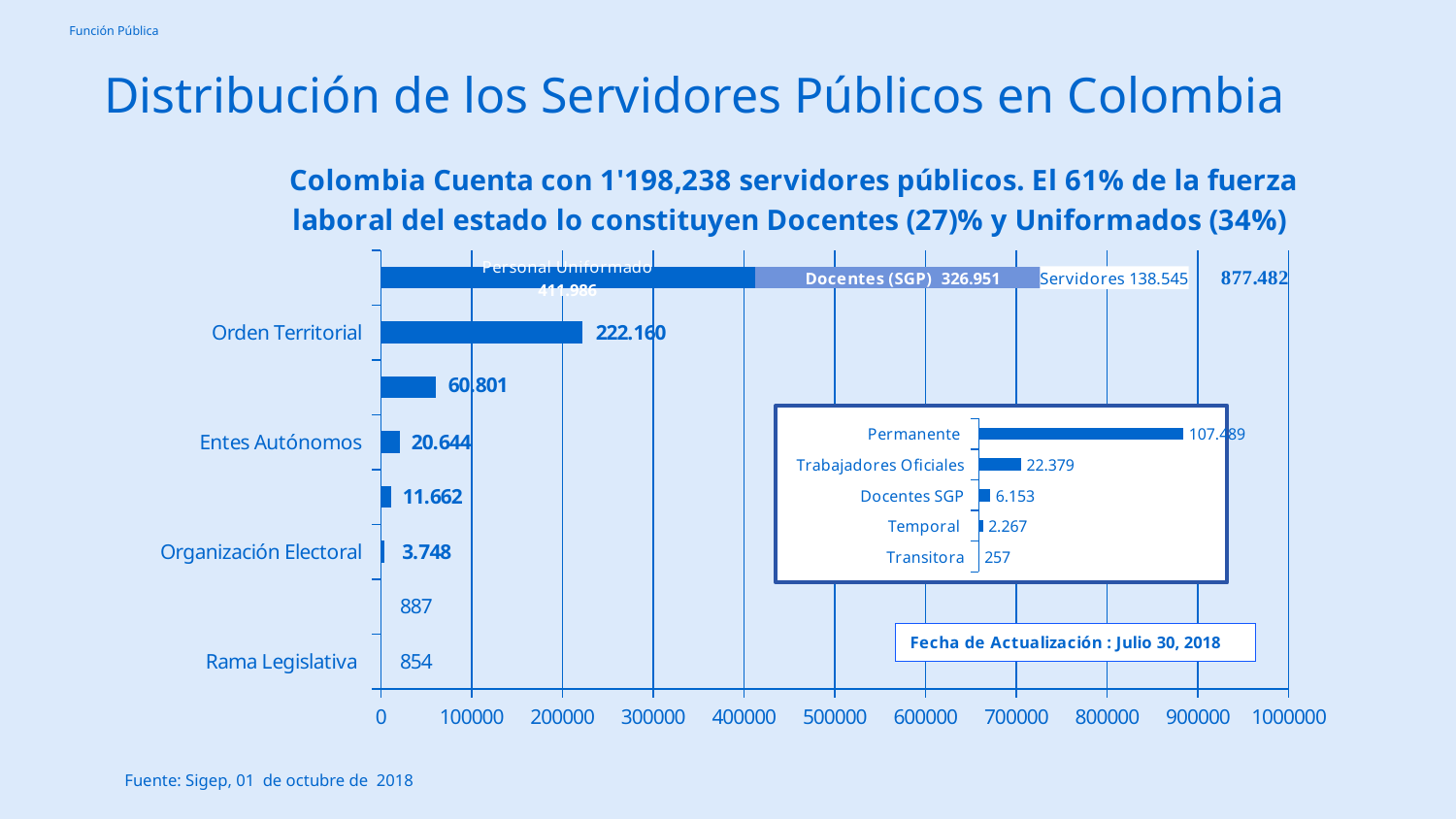
In the inset chart, how many categories are shown? 5 In the main chart, what is the value of the Docentes (SGP) segment in the top stacked bar? 326.951 In the main chart, what is the total shown at the end of the top stacked bar? 877.482 What kind of chart is the main chart on the slide? Bar chart In the main chart, what is the value for Orden Territorial? 222.160 In the inset chart, which category has the highest value? Permanente In the inset chart, which category has the lowest value? Transitora In the main chart, what is the value for Entes Autónomos? 20.644 In the main chart, is the value for Orden Territorial greater or less than 200000? greater In the main chart, which is larger, Orden Territorial or Organización Electoral? Orden Territorial In the main chart, what is the value for Rama Legislativa? 854 In the inset chart, what is the value for Trabajadores Oficiales? 22.379